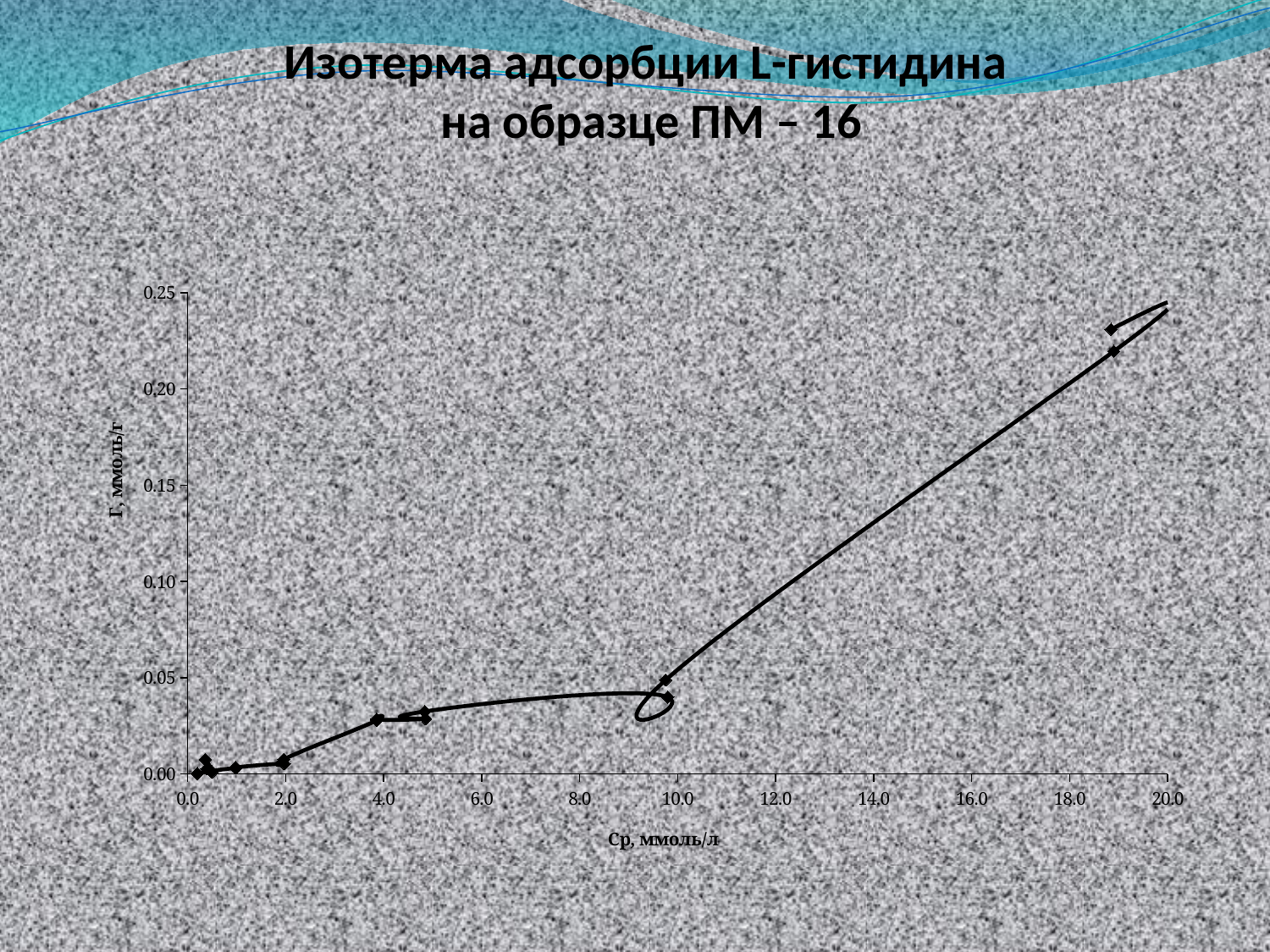
Which point has the highest Г value: the one near Ср = 2, near Ср = 10, or near Ср = 19? the one near Ср = 19 Is the value of Г for the points near Ср = 10 greater or less than 0.10? less Is the value of Г for the points near Ср = 19 greater or less than 0.20? greater Do the plotted values generally rise or fall as Ср increases along the x axis? rise What kind of chart is shown on the slide? line chart (scatter with smoothed line) What is the label of the x axis? Ср, ммоль/л Which has the larger Г value: the point near Ср = 10 or the point near Ср = 19? the point near Ср = 19 Is the value of Г for the point near Ср = 2 greater or less than 0.05? less What is the title of the chart? Изотерма адсорбции L-гистидина на образце ПМ – 16 What is the highest value shown on the y axis? 0.25